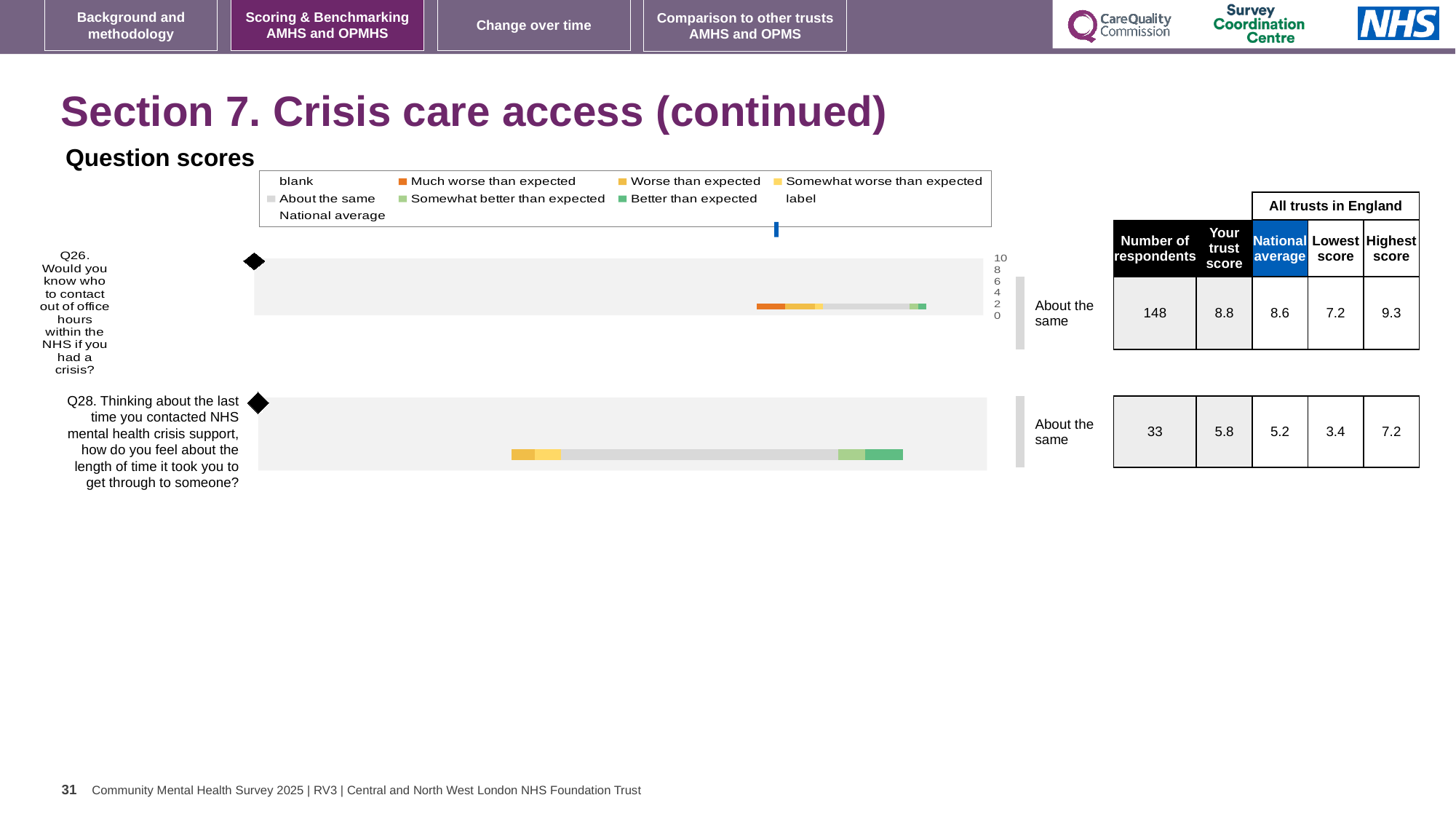
What is the trust score for Q28 (length of time it took to get through to someone)? 5.8 What is the highest score among all trusts in England for Q28? 7.2 Which question has more respondents, Q26 or Q28? Q26 How many questions are plotted in the question scores chart? 2 By how much does the trust score for Q28 exceed the national average for Q28? 0.6 How many respondents answered Q28? 33 Which question has the higher trust score, Q26 or Q28? Q26 What is the national average for Q26? 8.6 What is the trust score for Q26 (Would you know who to contact out of office hours within the NHS if you had a crisis?)? 8.8 What is the difference between the highest score and the lowest score for Q26? 2.1 What kind of chart is used to show the question scores on this slide? Bar chart What benchmark category label is shown next to the Q26 bar? About the same